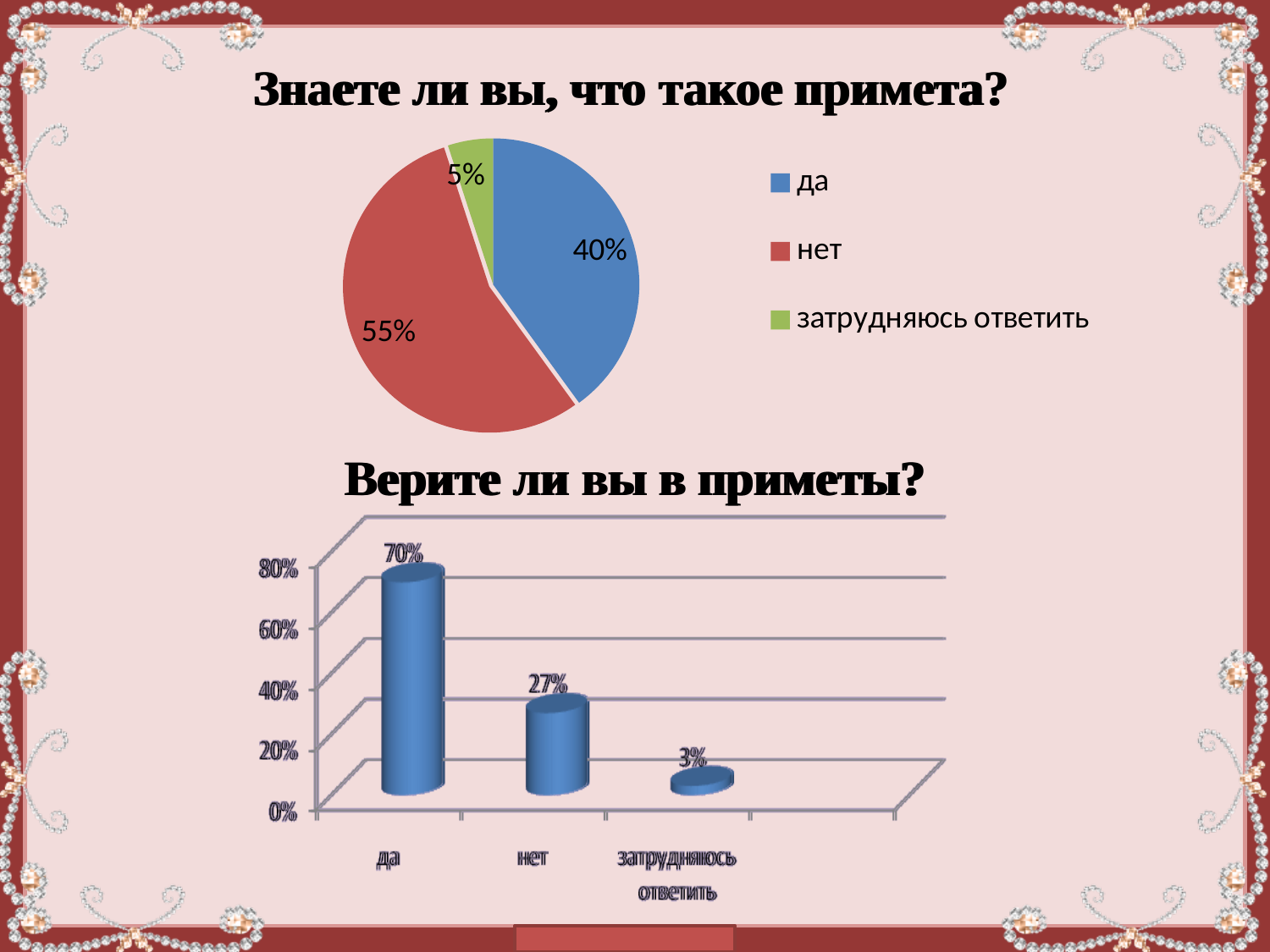
In the pie chart titled "Знаете ли вы, что такое примета?", which answer has the smallest slice? затрудняюсь ответить In the pie chart titled "Знаете ли вы, что такое примета?", how many entries does the legend list? 3 In the pie chart titled "Знаете ли вы, что такое примета?", what share of respondents answered "да"? 40% In the bar chart titled "Верите ли вы в приметы?", what is the value for "да"? 70% In the pie chart titled "Знаете ли вы, что такое примета?", which answer has the largest slice? нет In the pie chart titled "Знаете ли вы, что такое примета?", what is the difference between the "нет" and "да" shares? 15% In the pie chart titled "Знаете ли вы, что такое примета?", what colour is the "да" slice? Blue In the pie chart titled "Знаете ли вы, что такое примета?", what share of respondents answered "нет"? 55% In the bar chart titled "Верите ли вы в приметы?", how many categories are shown on the x axis? 3 In the bar chart titled "Верите ли вы в приметы?", what is the difference between the values for "да" and "нет"? 43% What kind of chart is the lower chart titled "Верите ли вы в приметы?"? Bar chart In the bar chart titled "Верите ли вы в приметы?", what is the value for "нет"? 27%